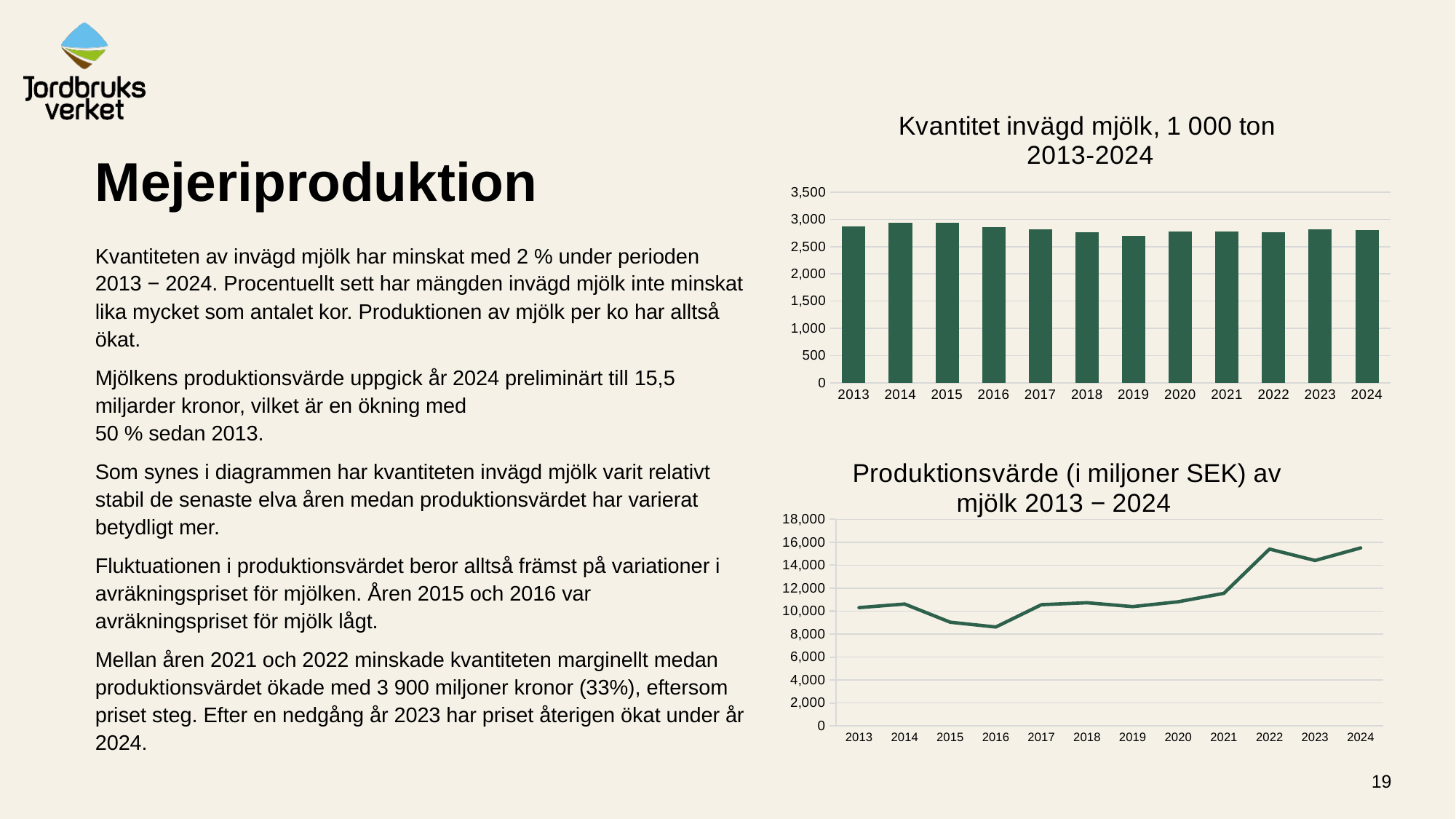
In the 'Kvantitet invägd mjölk' bar chart, is the value for 2013 greater or less than 2,500? greater In the 'Produktionsvärde' line chart, is the value for 2016 greater or less than 10,000? less In the 'Produktionsvärde' line chart, is the value for 2022 greater or less than 14,000? greater What is the title of the bar chart on the slide? Kvantitet invägd mjölk, 1 000 ton 2013-2024 In the 'Kvantitet invägd mjölk' bar chart, how many years are shown on the x axis? 12 In the 'Produktionsvärde' line chart, which year has the lowest value? 2016 In the 'Produktionsvärde' line chart, does the value rise or fall between 2021 and 2022? rise In the 'Produktionsvärde' line chart, which is larger, the value for 2022 or the value for 2016? 2022 In the 'Produktionsvärde' line chart, how many years are plotted? 12 What kind of chart is the 'Produktionsvärde (i miljoner SEK) av mjölk 2013 − 2024' chart? line chart What kind of chart is the 'Kvantitet invägd mjölk, 1 000 ton 2013-2024' chart? bar chart